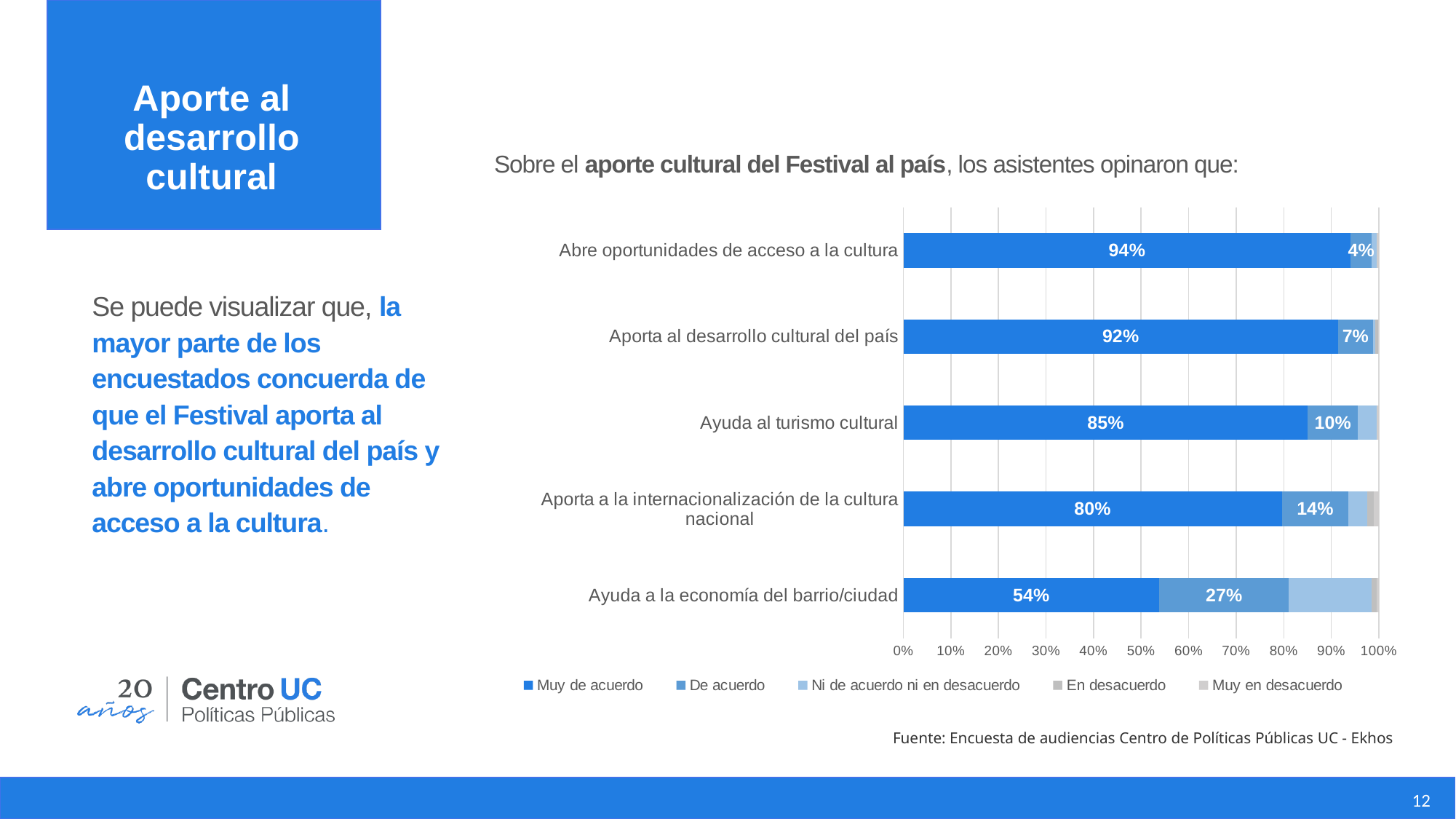
What kind of chart is shown on the slide? stacked bar chart What is the difference between the 'Muy de acuerdo' values for 'Aporta al desarrollo cultural del país' and 'Ayuda a la economía del barrio/ciudad'? 38% How many series does the legend list? 5 Which is larger: the 'De acuerdo' value for 'Ayuda al turismo cultural' or for 'Aporta al desarrollo cultural del país'? Ayuda al turismo cultural Which statement has the highest 'Muy de acuerdo' value? Abre oportunidades de acceso a la cultura How many categories (statements) does the chart show? 5 What is the 'Muy de acuerdo' value for 'Abre oportunidades de acceso a la cultura'? 94% Which series is shown in the darkest blue, listed first in the legend? Muy de acuerdo What is the 'De acuerdo' value for 'Aporta a la internacionalización de la cultura nacional'? 14% What is the 'De acuerdo' value for 'Ayuda a la economía del barrio/ciudad'? 27% What is the 'Muy de acuerdo' value for 'Ayuda al turismo cultural'? 85% Which statement has the lowest 'Muy de acuerdo' value? Ayuda a la economía del barrio/ciudad